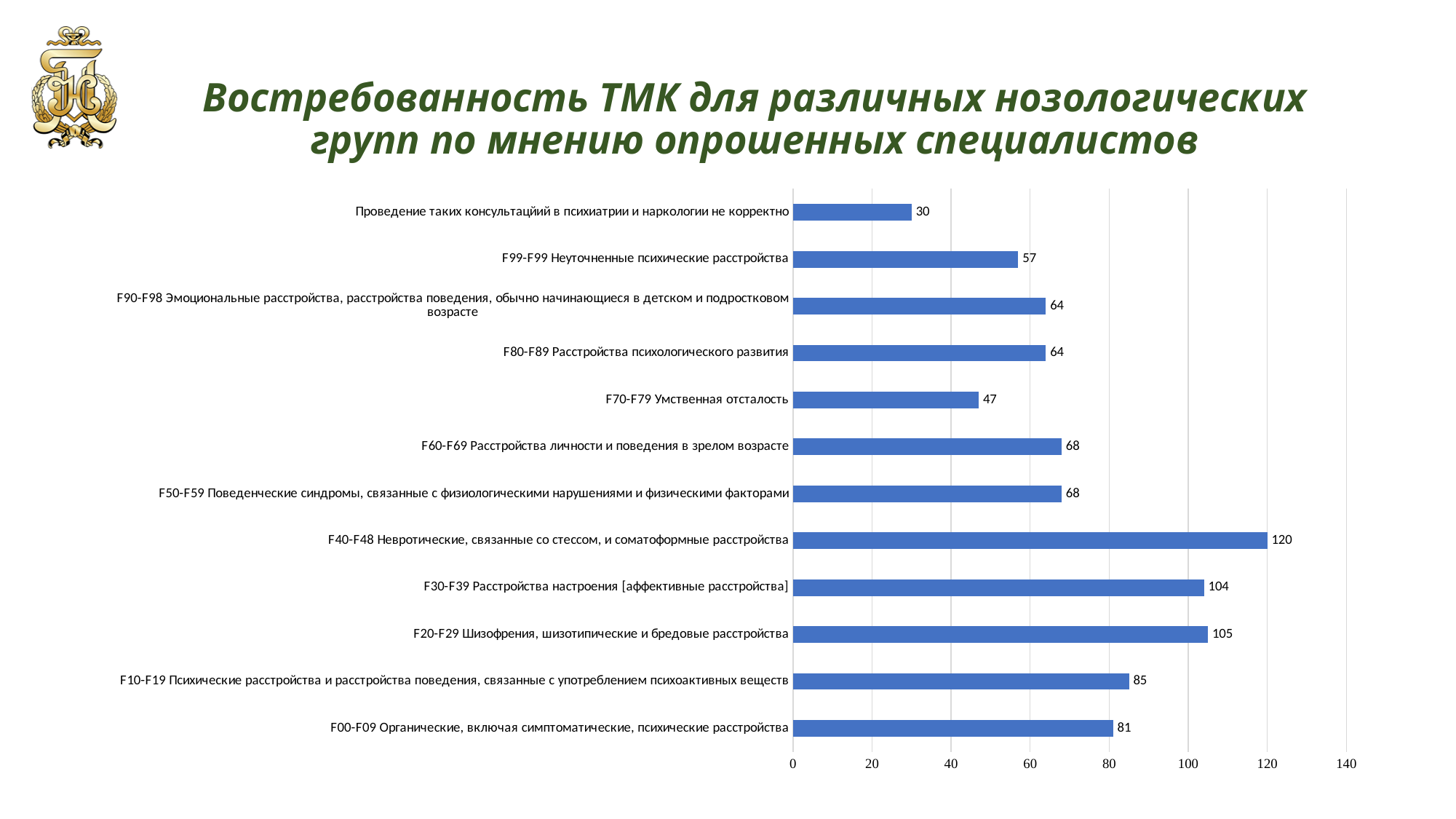
What is the value for F00-F09 Органические, включая симптоматические, психические расстройства? 81 What is the difference between the values for F40-F48 and F10-F19? 35 What is the difference between the values for F20-F29 and F70-F79? 58 How many categories are shown in the chart? 12 Which category has the lowest value? Проведение таких консультацйий в психиатрии и наркологии не корректно What is the value for F10-F19 Психические расстройства и расстройства поведения, связанные с употреблением психоактивных веществ? 85 Which is larger, the value for F30-F39 Расстройства настроения or the value for F60-F69 Расстройства личности и поведения в зрелом возрасте? F30-F39 Расстройства настроения What is the value for F40-F48 Невротические, связанные со стессом, и соматоформные расстройства? 120 Which category has the highest value? F40-F48 Невротические, связанные со стессом, и соматоформные расстройства What type of chart is shown on the slide? Bar chart What is the title of the slide? Востребованность ТМК для различных нозологических групп по мнению опрошенных специалистов What is the value for F70-F79 Умственная отсталость? 47